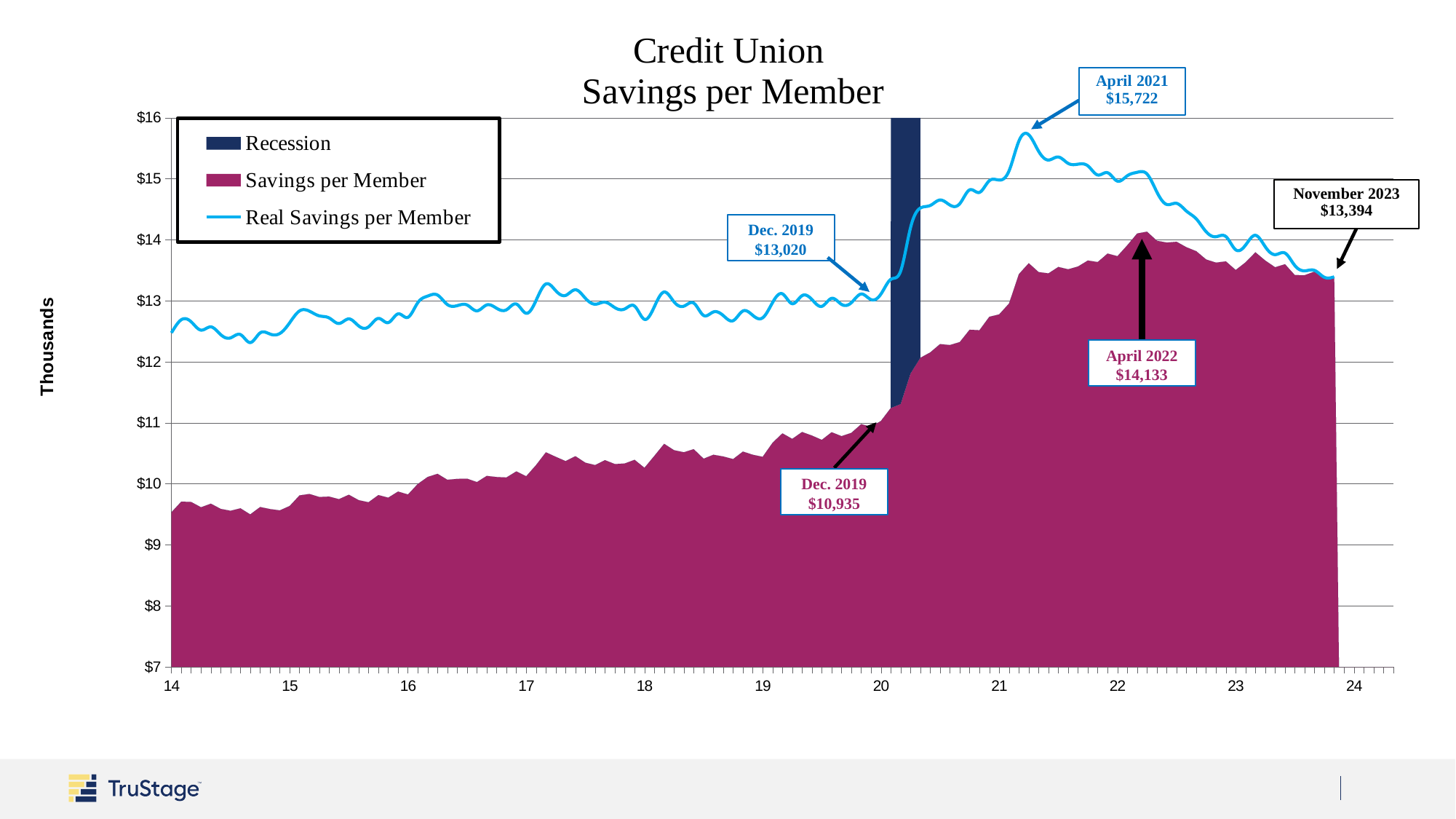
What is the difference between Real Savings per Member and Savings per Member in Dec. 2019? $2,085 What was Savings per Member in April 2022? $14,133 Does Savings per Member generally rise or fall from 2014 to 2022? rise What was Real Savings per Member in April 2021? $15,722 How many entries does the legend list? 3 What was Savings per Member in Dec. 2019? $10,935 What value is annotated for November 2023? $13,394 Which is larger: Real Savings per Member in April 2021 or Savings per Member in April 2022? Real Savings per Member in April 2021 What does the dark blue vertical bar in the chart represent? Recession What was Real Savings per Member in Dec. 2019? $13,020 Is Savings per Member at the start of 2014 greater or less than $10? less How much higher was Savings per Member in April 2022 than in Dec. 2019? $3,198